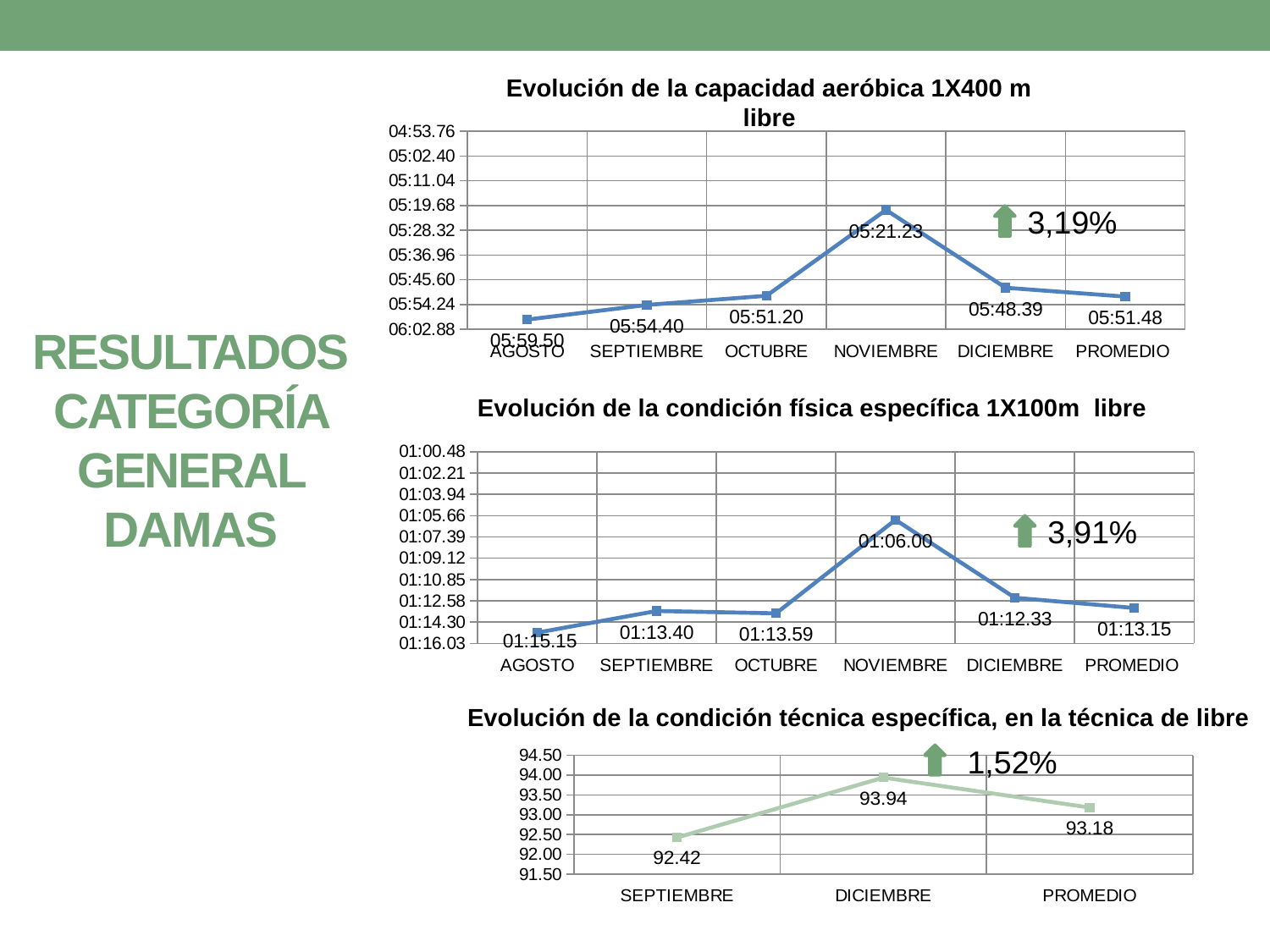
In the chart 'Evolución de la condición física específica 1X100m libre', what is the value for DICIEMBRE? 01:12.33 In the chart 'Evolución de la condición técnica específica, en la técnica de libre', what is the value for DICIEMBRE? 93.94 In the chart 'Evolución de la condición física específica 1X100m libre', what is the value for PROMEDIO? 01:13.15 In the chart 'Evolución de la condición técnica específica, en la técnica de libre', which category has the lowest value? SEPTIEMBRE In the chart 'Evolución de la condición técnica específica, en la técnica de libre', what is the difference between the DICIEMBRE and SEPTIEMBRE values? 1.52 In the chart 'Evolución de la capacidad aeróbica 1X400 m libre', which category has the lowest time value? NOVIEMBRE What percentage is shown next to the green arrow in the chart 'Evolución de la condición física específica 1X100m libre'? 3,91% In the chart 'Evolución de la condición física específica 1X100m libre', which category has the highest time value? AGOSTO In the chart 'Evolución de la capacidad aeróbica 1X400 m libre', what is the value for NOVIEMBRE? 05:21.23 In the chart 'Evolución de la capacidad aeróbica 1X400 m libre', what is the value for AGOSTO? 05:59.50 What kind of chart is 'Evolución de la condición física específica 1X100m libre'? line chart How many categories are shown on the x axis of the chart 'Evolución de la capacidad aeróbica 1X400 m libre'? 6